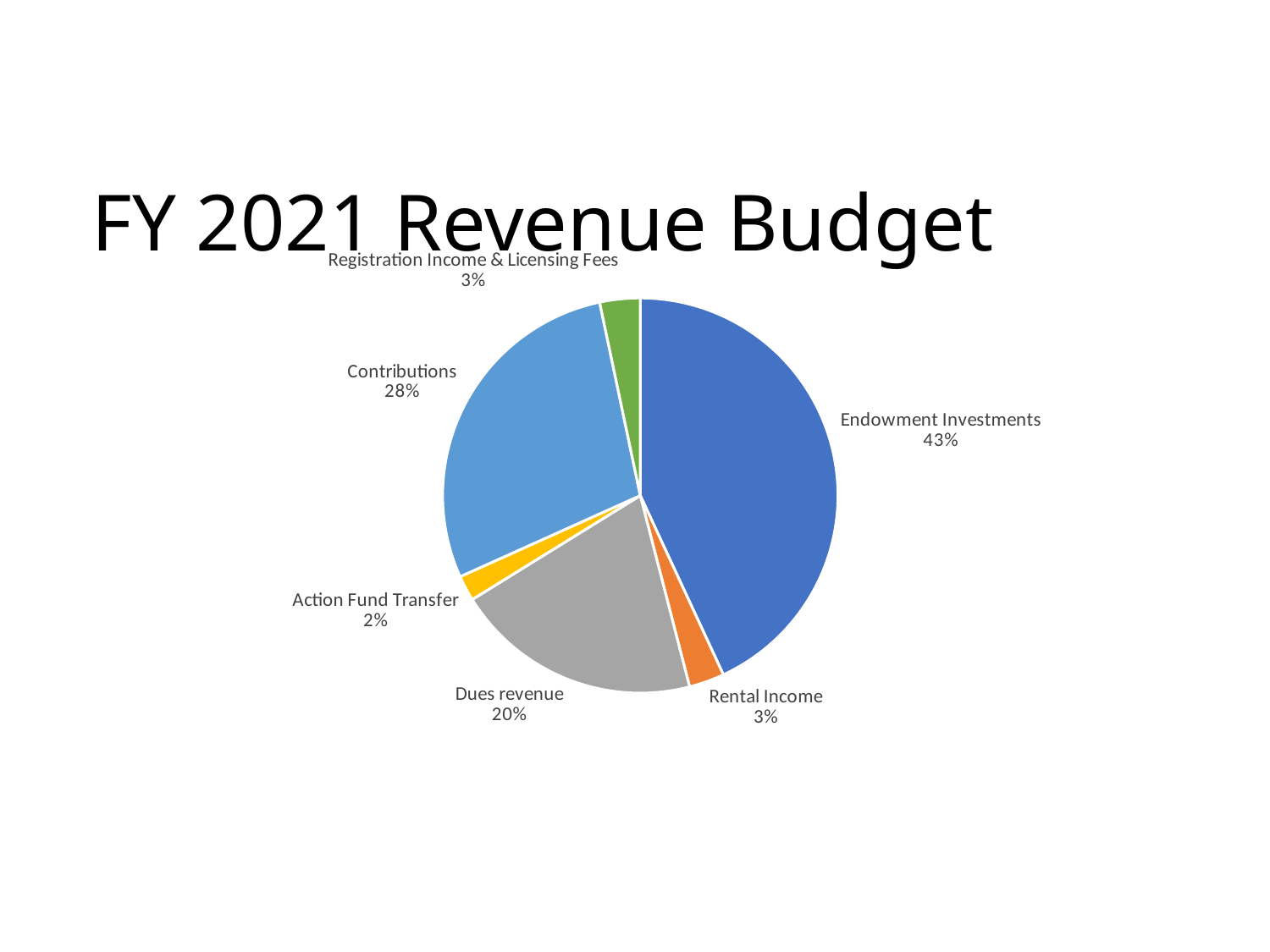
Which category has the smallest slice of the pie? Action Fund Transfer Which category has the largest slice of the pie? Endowment Investments What is the difference in percentage points between Endowment Investments and Contributions? 15 What share of the FY 2021 Revenue Budget comes from Endowment Investments? 43% What kind of chart is shown on the slide? pie chart What percentage is shown for Dues revenue? 20% How many categories are shown in the pie chart? 6 What percentage is shown for Action Fund Transfer? 2% Which is larger, Contributions or Dues revenue? Contributions What percentage is shown for Rental Income? 3% What is the title of the slide? FY 2021 Revenue Budget What share of the pie is Contributions? 28%